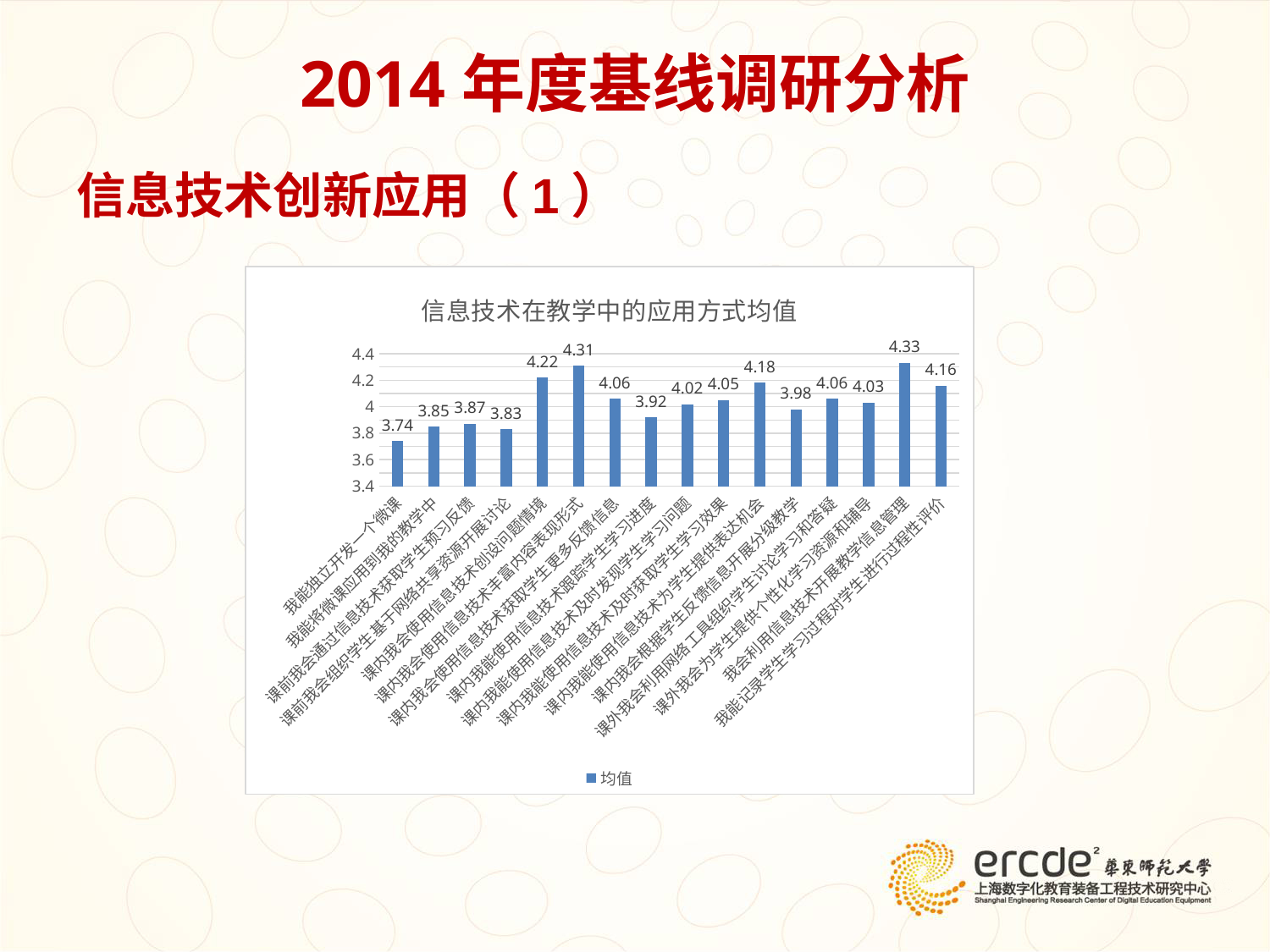
How many series does the legend list? 1 Which is larger: the value for 课内我会使用信息技术创设问题情境 or the value for 课内我能使用信息技术为学生提供表达机会? 课内我会使用信息技术创设问题情境 What is the difference between the highest value (4.33) and the lowest value (3.74)? 0.59 How many categories (bars) are plotted in the chart? 16 What is the value for 我能记录学生学习过程对学生进行过程性评价? 4.16 What type of chart is shown on the slide? bar chart Which category has the highest value? 我会利用信息技术开展教学信息管理 What is the value for 课内我会使用信息技术丰富内容表现形式? 4.31 What is the title of the chart? 信息技术在教学中的应用方式均值 Which category has the lowest value? 我能独立开发一个微课 What is the value for 我能独立开发一个微课? 3.74